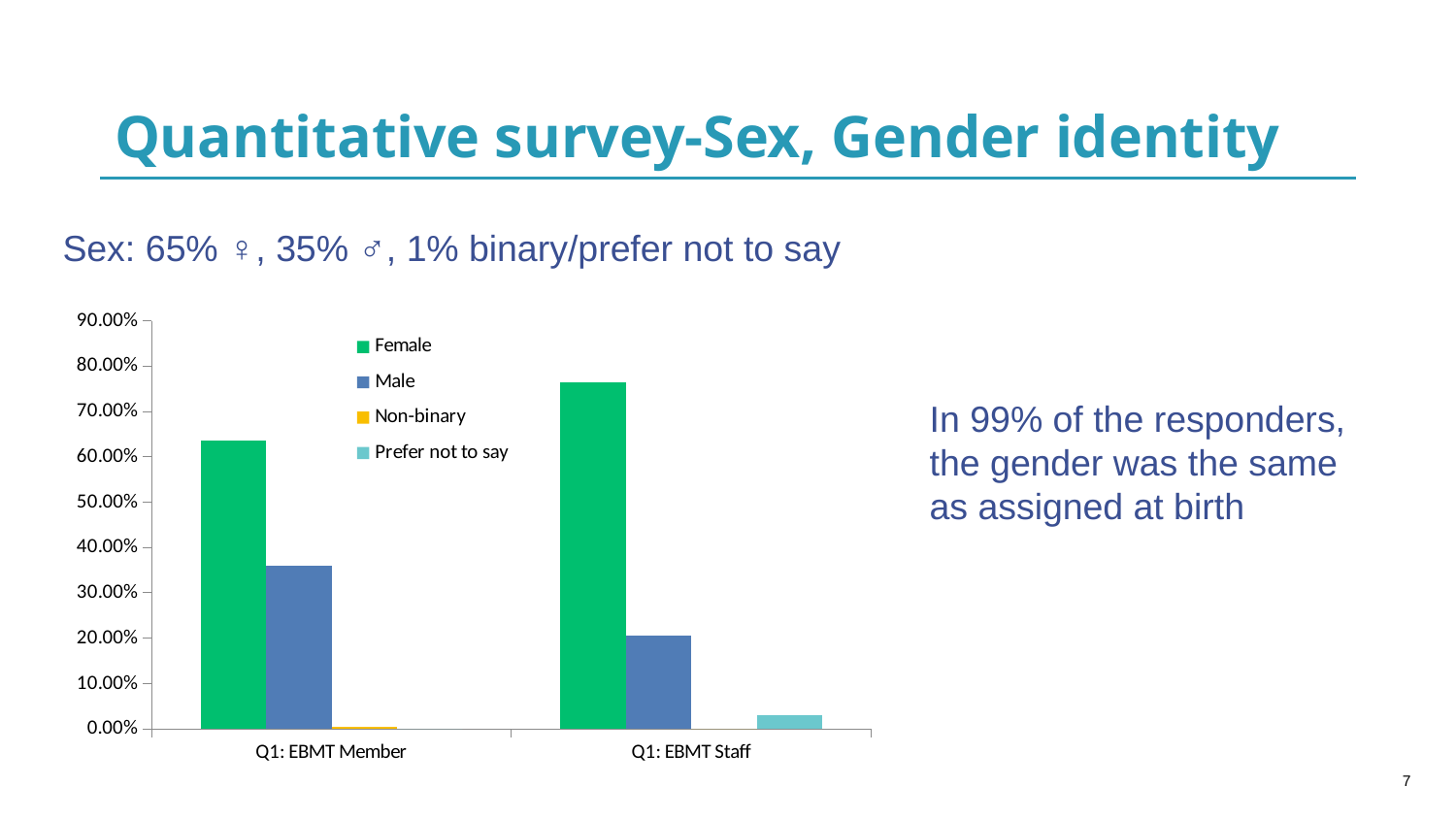
Is the Female bar taller for Q1: EBMT Member or for Q1: EBMT Staff? Q1: EBMT Staff Is the Male value for Q1: EBMT Staff greater or less than 30.00%? less Is the Female value for Q1: EBMT Staff greater or less than 70.00%? greater Is the Female value for Q1: EBMT Member greater or less than 70.00%? less Which series has the tallest bar for Q1: EBMT Staff? Female What kind of chart is shown on the slide? bar chart How many categories are shown on the x axis of the chart? 2 Which series has the tallest bar for Q1: EBMT Member? Female Is the Male bar taller for Q1: EBMT Member or for Q1: EBMT Staff? Q1: EBMT Member How many series does the chart legend list? 4 Which colour represents the Non-binary series in the chart legend? yellow